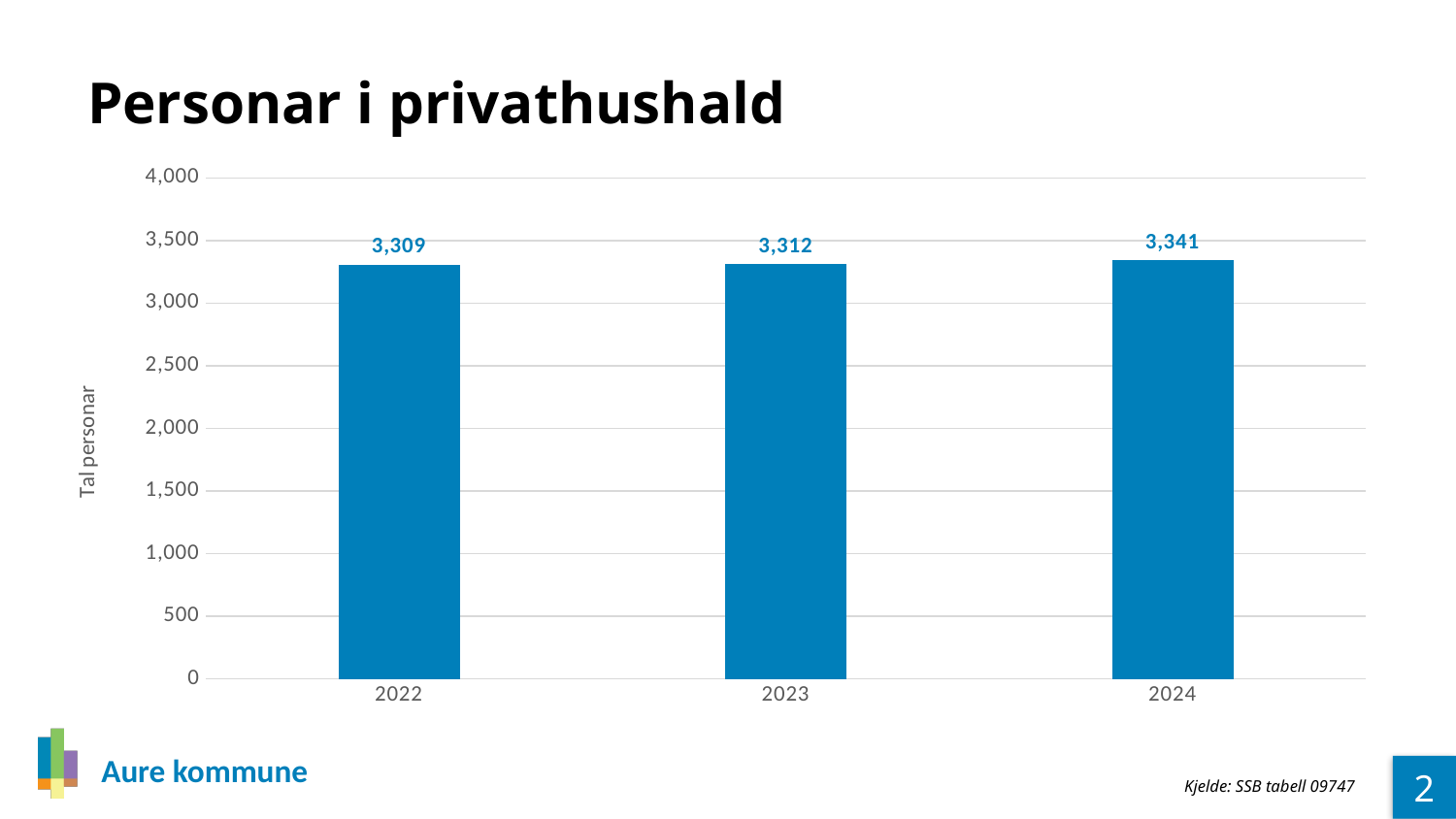
What is the value for 2023? 3,312 What is the difference between the values for 2024 and 2022? 32 What is the value for 2024? 3,341 Is the value for 2022 greater or less than 3,500? less Which year has the highest value? 2024 What kind of chart is shown on the slide? bar chart What is the value for 2022? 3,309 How many years are shown on the x axis? 3 Which is larger, the value for 2024 or the value for 2023? 2024 Which year has the lowest value? 2022 What is the difference between the values for 2023 and 2022? 3 Do the values rise or fall from 2022 to 2024? rise